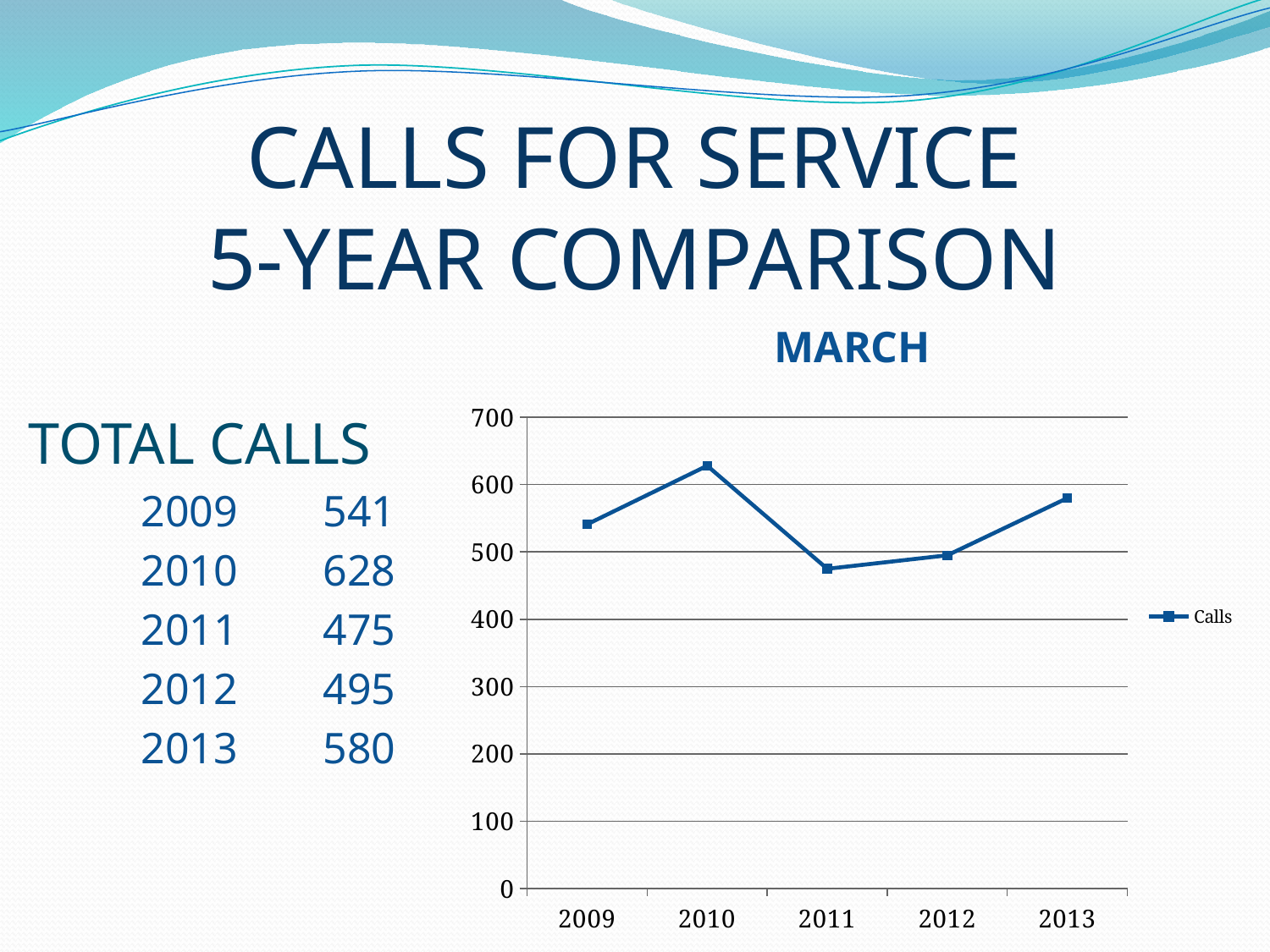
How many series does the chart legend list? 1 What is the difference in calls between 2010 and 2011? 153 What is the title of the chart? MARCH What kind of chart is shown on the slide? line chart Which year has the highest number of calls? 2010 How many years are plotted on the x axis of the chart? 5 What is the number of calls for 2010? 628 Which year has more calls, 2009 or 2013? 2013 What is the number of calls for 2011? 475 Do the calls rise or fall from 2011 to 2013? rise Is the value for 2012 greater or less than 500? less Which year has the lowest number of calls? 2011